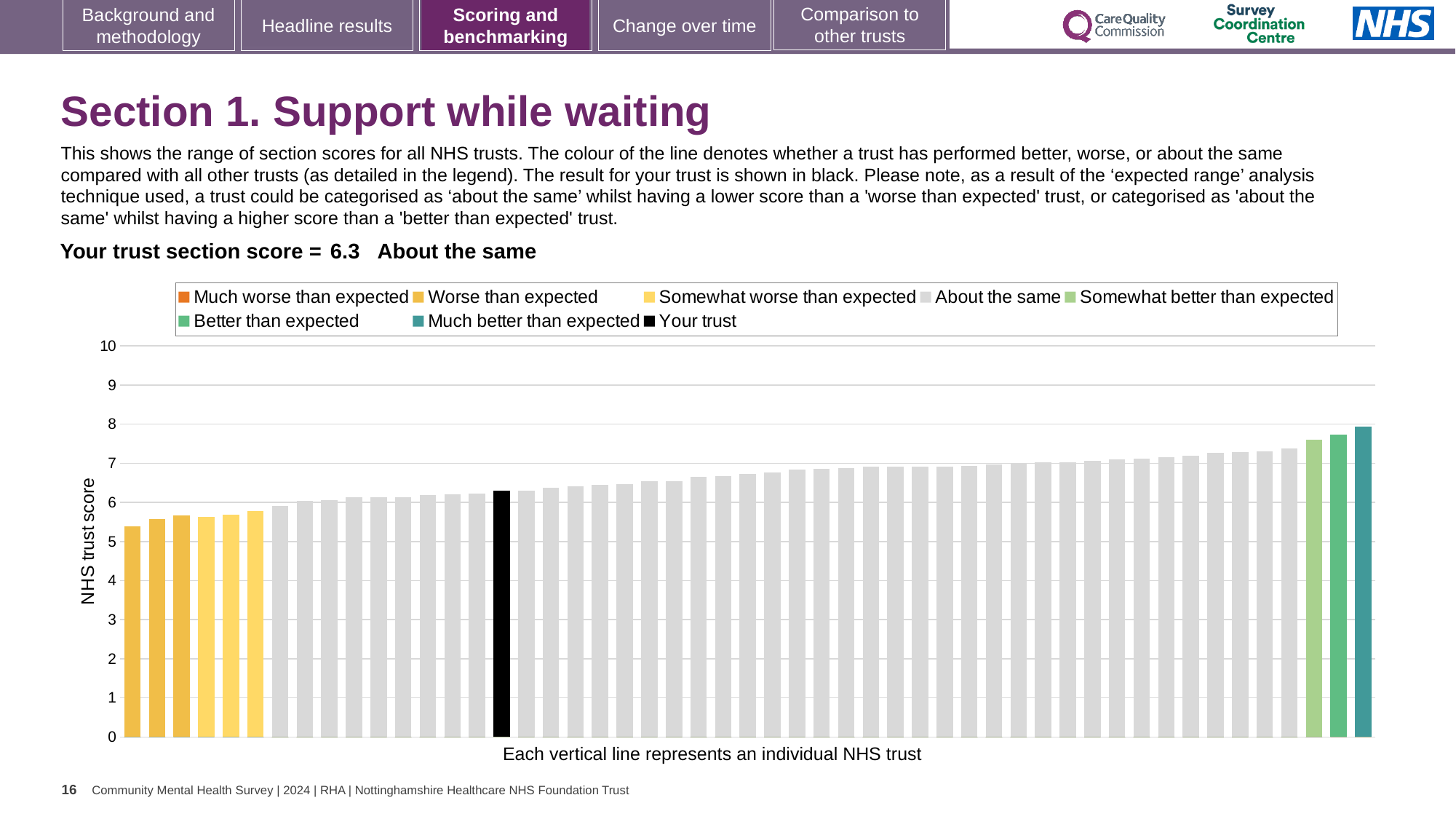
What colour is the bar representing your trust? black Do the bar values rise or fall from left to right along the x axis? rise Which is larger, the score of the rightmost bar or your trust's score? the rightmost bar Is the value for your trust greater or less than 5? greater What category does your trust's score fall into according to the slide? About the same How many entries does the chart legend list? 8 What is the highest value shown on the vertical axis? 10 Is the value of the tallest bar (rightmost) greater or less than 7? greater Is the value of the shortest bar (leftmost) greater or less than 6? less What kind of chart is shown on the slide? bar chart What is the label on the vertical axis of the chart? NHS trust score What is the section score for your trust shown on the slide? 6.3